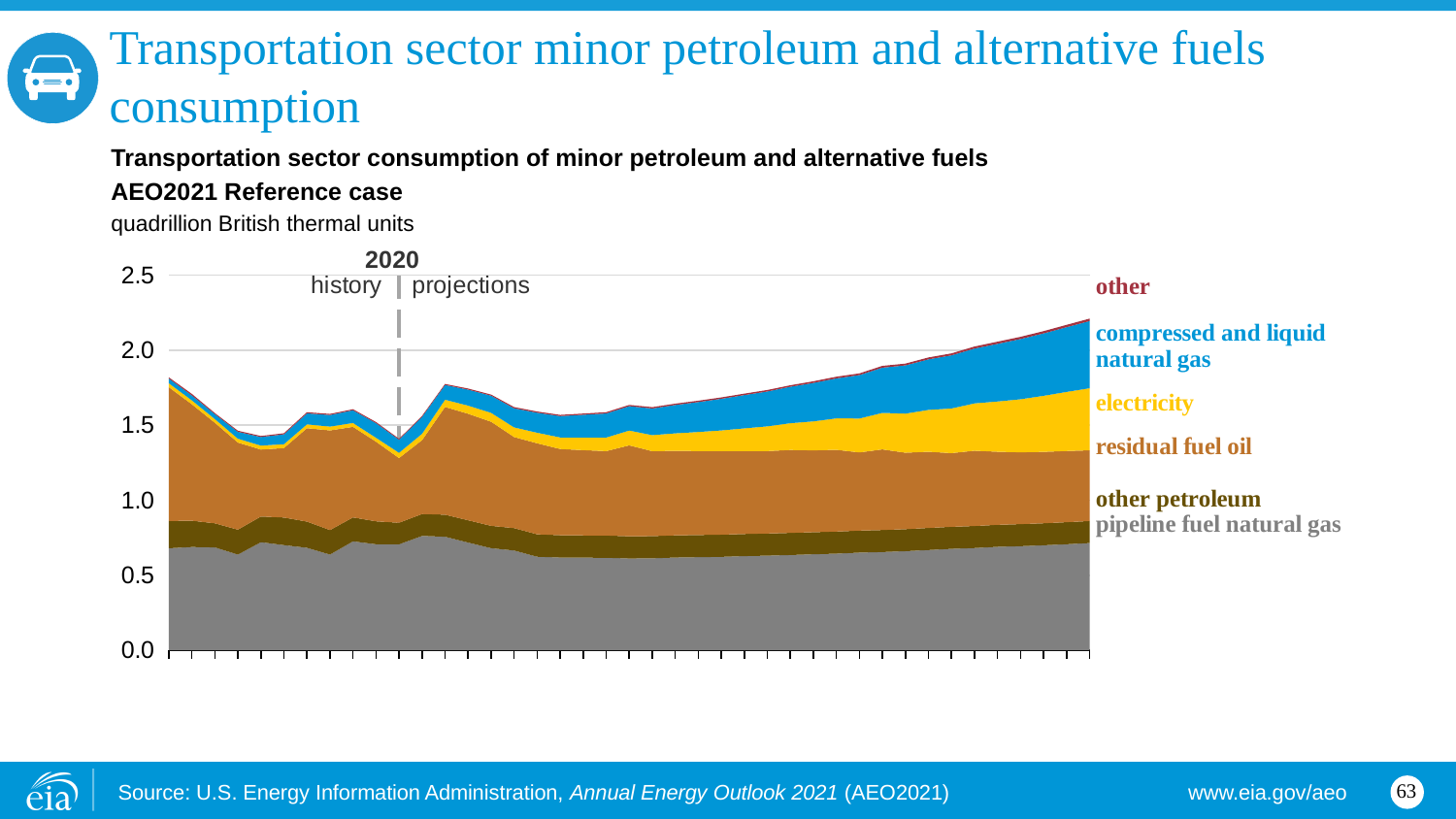
How many series does the legend list? 6 Is the total consumption at the right end of the chart greater or less than 2.0? greater Which series is the largest band in the stack? pipeline fuel natural gas What unit is the y axis measured in? quadrillion British thermal units Is the total consumption at the left end of the chart greater or less than 2.0? less What kind of chart is shown on the slide? stacked area chart Does the compressed and liquid natural gas band grow or shrink over the projection period? grow Which is larger at the right end of the chart, pipeline fuel natural gas or other petroleum? pipeline fuel natural gas Is the value for pipeline fuel natural gas at the right end of the chart greater or less than 1.0? less Which series is the smallest band in the stack? other Does total consumption rise or fall over the projection period after 2020? rise Which year separates history from projections on the chart? 2020